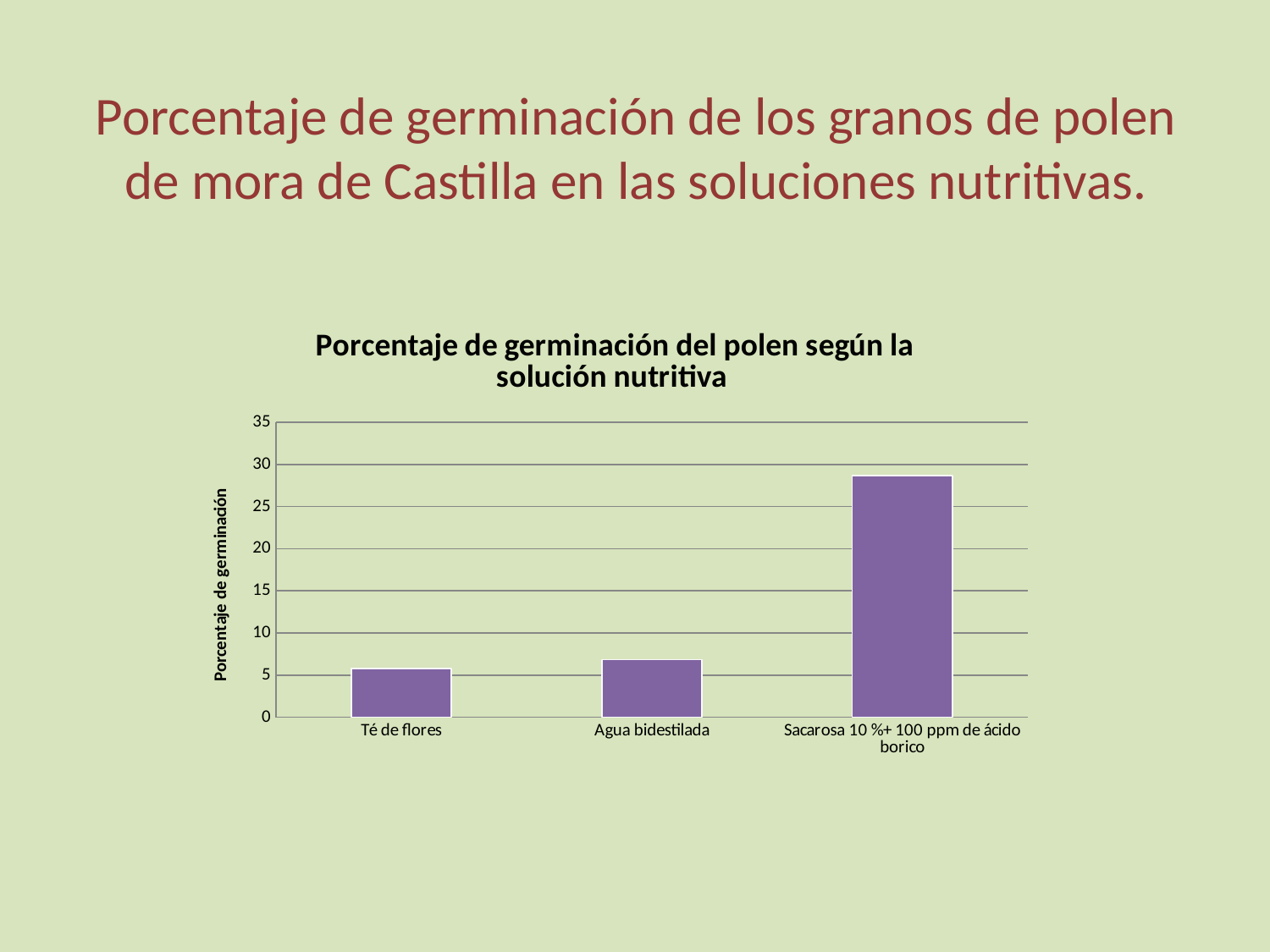
Do the values rise or fall from left to right along the x axis? rise Which has a higher germination percentage, Agua bidestilada or Sacarosa 10 %+ 100 ppm de ácido borico? Sacarosa 10 %+ 100 ppm de ácido borico Which nutrient solution has the highest germination percentage? Sacarosa 10 %+ 100 ppm de ácido borico What is the title of the chart? Porcentaje de germinación del polen según la solución nutritiva Is the value for Agua bidestilada greater or less than 10? less Which nutrient solution has the lowest germination percentage? Té de flores Is the value for Sacarosa 10 %+ 100 ppm de ácido borico greater or less than 30? less What kind of chart is shown on the slide? bar chart What is the label of the vertical axis? Porcentaje de germinación How many categories (nutrient solutions) are plotted in the chart? 3 Is the value for Té de flores greater or less than 10? less